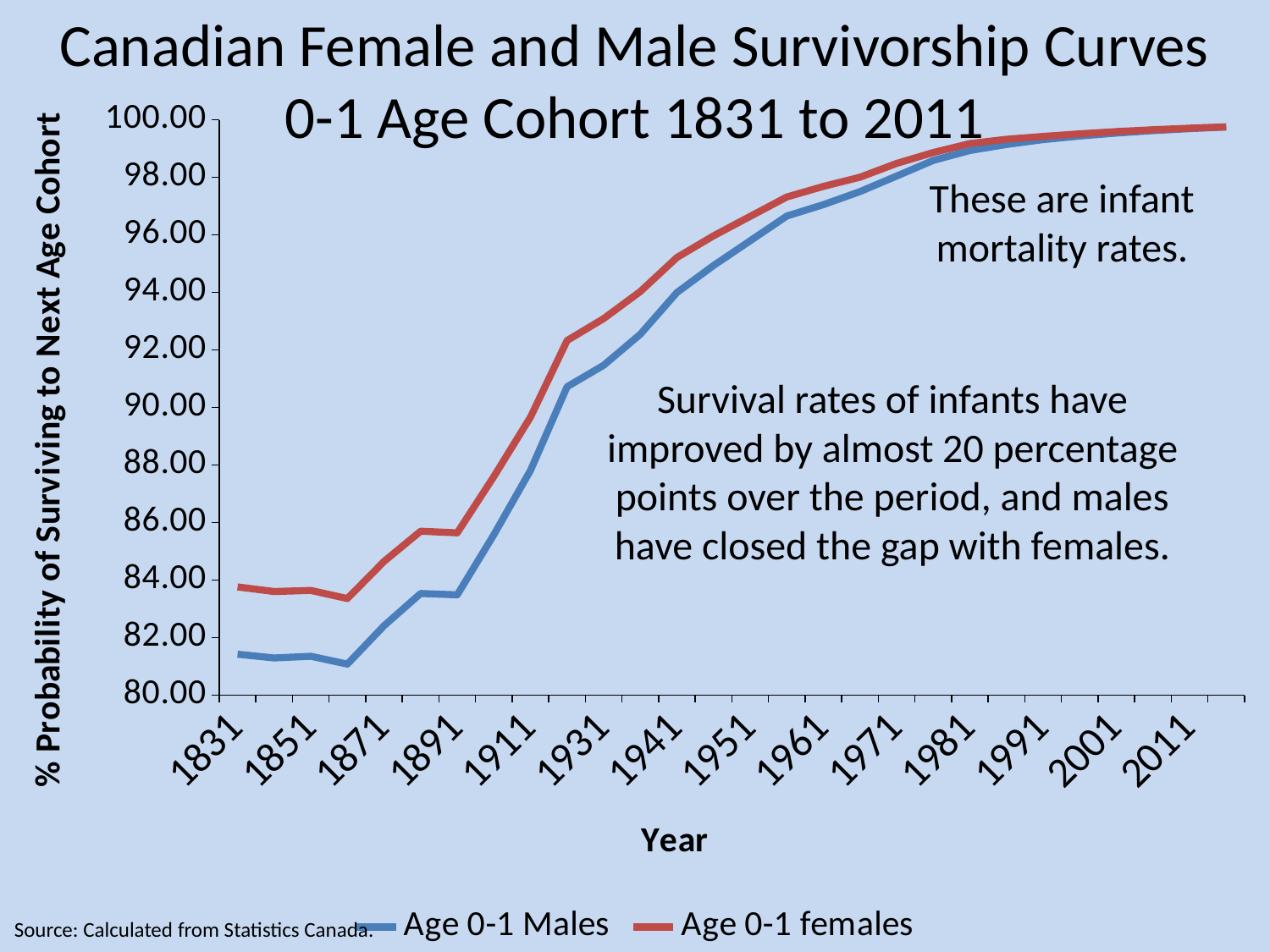
In 1891, which series has the higher value, Age 0-1 Males or Age 0-1 females? Age 0-1 females What are the two series named in the legend? Age 0-1 Males and Age 0-1 females How many series does the legend list? 2 Is the value for Age 0-1 females in 1951 greater or less than 94.00? greater In 1831, which series has the higher value, Age 0-1 Males or Age 0-1 females? Age 0-1 females Do the survivorship values for Age 0-1 females generally rise or fall from 1831 to 2011? rise Is the value for Age 0-1 females in 1831 greater or less than 82.00? greater Is the value for Age 0-1 Males in 1961 greater or less than 96.00? greater What kind of chart is shown on the slide? line chart Do the survivorship values for Age 0-1 Males generally rise or fall from 1831 to 2011? rise What is the title of the chart? Canadian Female and Male Survivorship Curves 0-1 Age Cohort 1831 to 2011